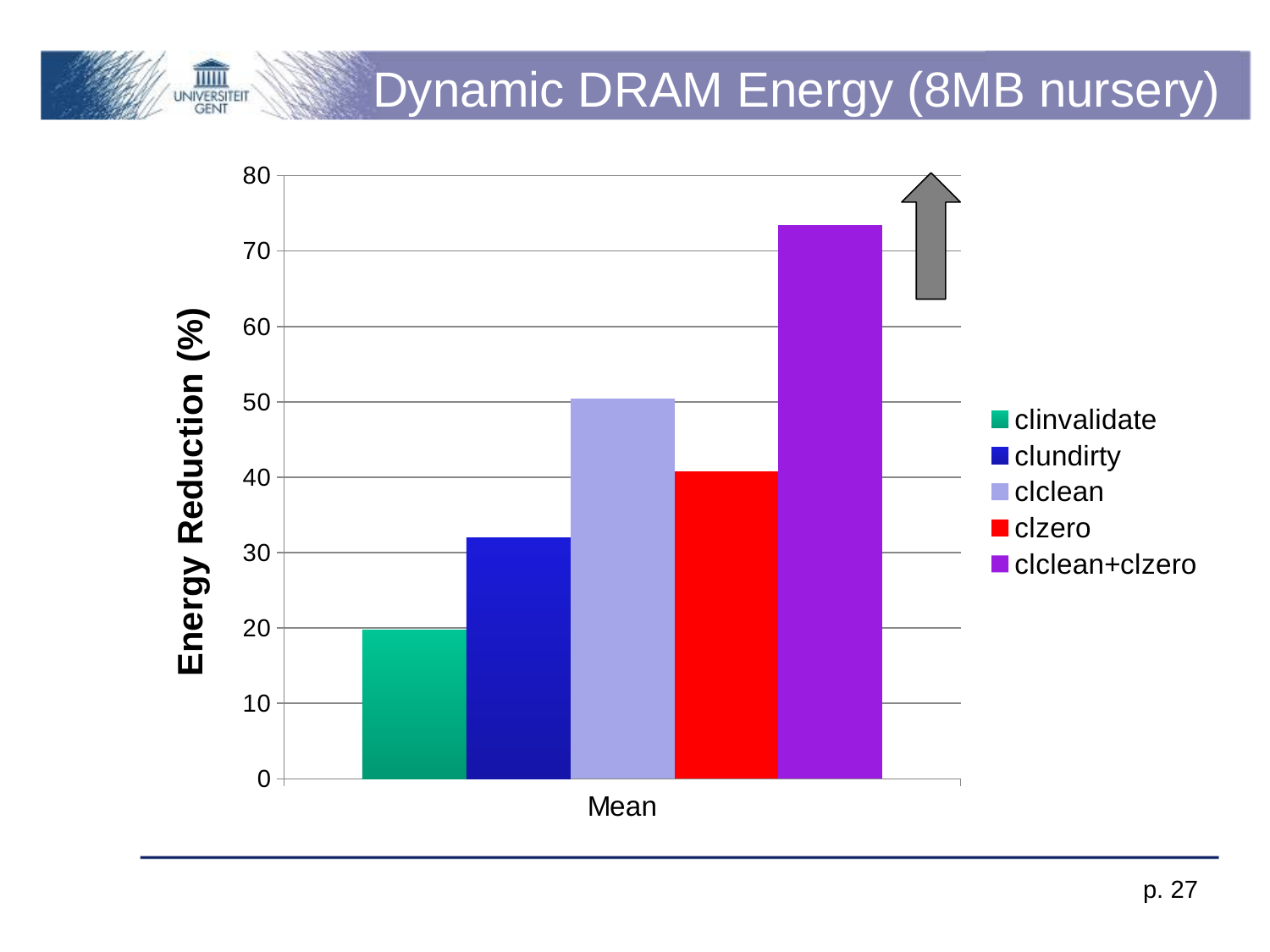
Which series has the highest energy reduction? clclean+clzero Is the value for clinvalidate greater or less than 30? less What kind of chart is shown on the slide? bar chart Is the value for clzero greater or less than 50? less Is the value for clclean greater or less than 60? less Which series has the lowest energy reduction? clinvalidate Which has a larger energy reduction, clclean or clzero? clclean How many series does the legend list? 5 What is the label of the y axis? Energy Reduction (%) How many categories are shown on the x axis? 1 Which has a larger energy reduction, clundirty or clinvalidate? clundirty